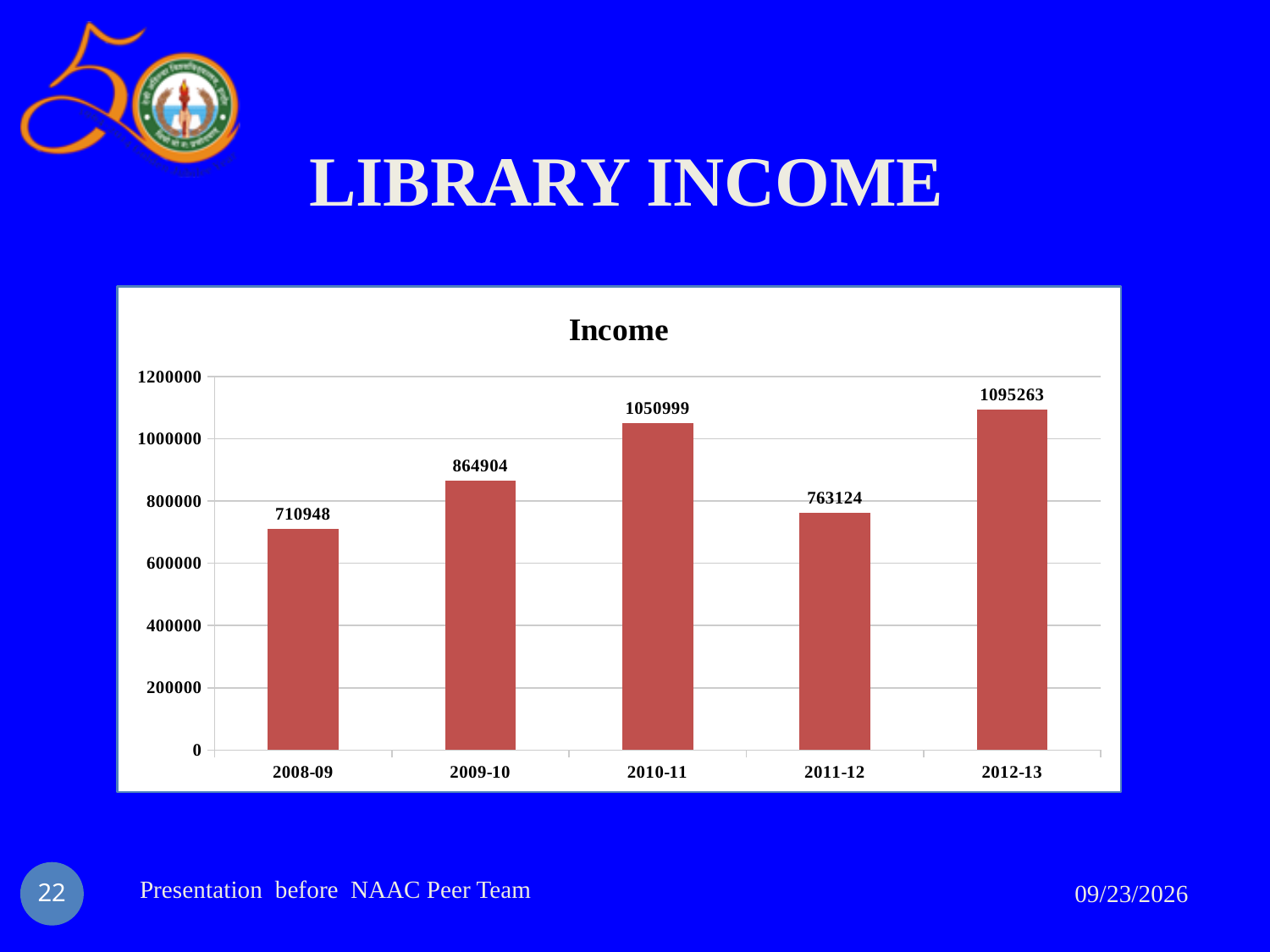
What is the difference between the income in 2009-10 and 2008-09? 153956 Which year has the highest income? 2012-13 Is the income for 2011-12 greater or less than 800000? less Which year has the lowest income? 2008-09 What kind of chart is shown on the slide? bar chart What is the difference between the income in 2012-13 and 2010-11? 44264 What is the income value for 2010-11? 1050999 What is the income value for 2011-12? 763124 What is the income value for 2008-09? 710948 How many years are shown on the chart? 5 What is the title of the chart? Income Which is larger, the income in 2009-10 or in 2011-12? 2009-10